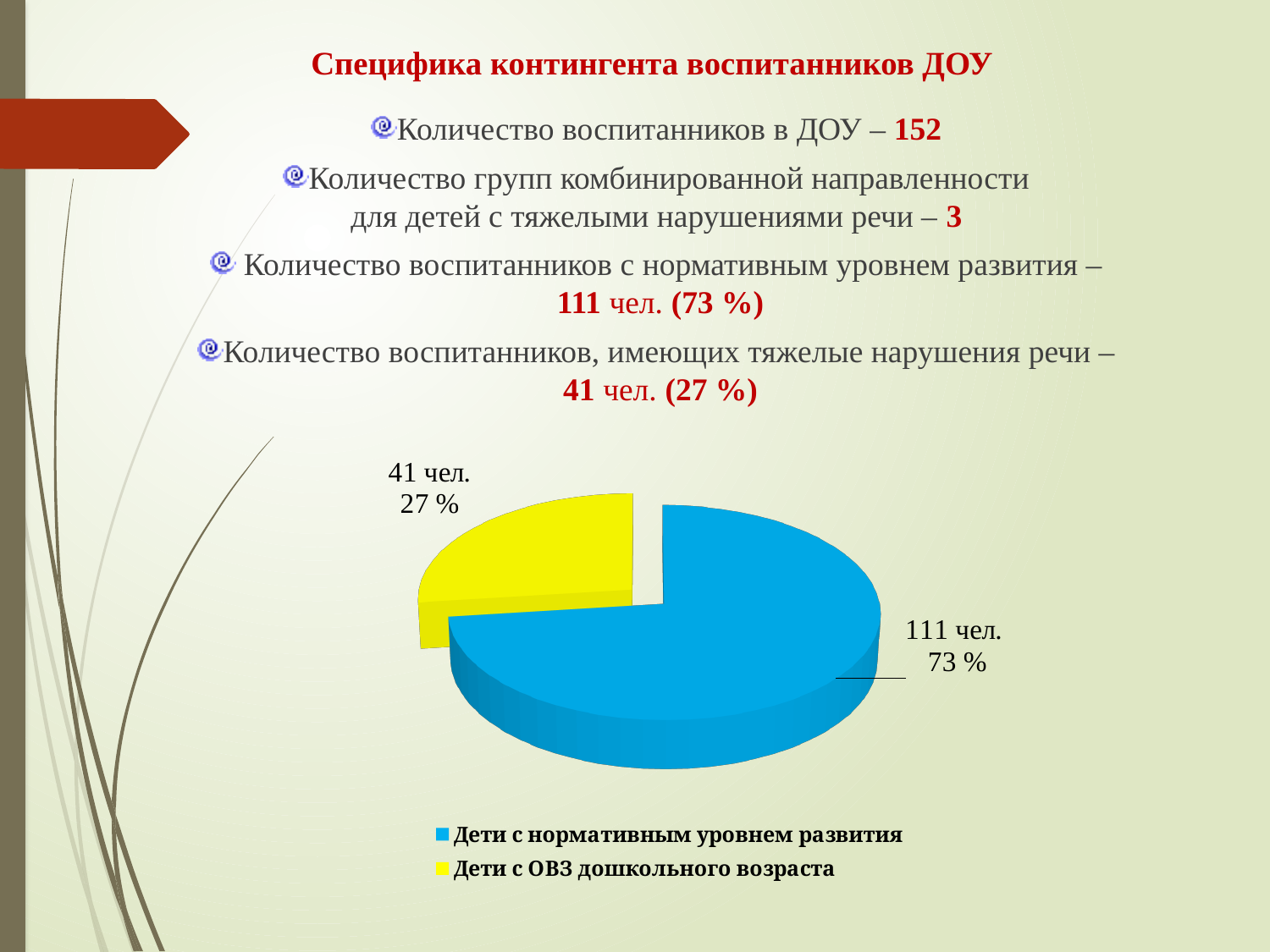
Which slice of the pie chart is the smallest? Дети с ОВЗ дошкольного возраста Which slice of the pie chart is the largest? Дети с нормативным уровнем развития What kind of chart is shown on the slide? pie chart How many slices does the pie chart have? 2 What share of the pie does the slice 'Дети с нормативным уровнем развития' represent? 73 % Which is larger: the slice 'Дети с нормативным уровнем развития' or the slice 'Дети с ОВЗ дошкольного возраста'? Дети с нормативным уровнем развития What share of the pie does the slice 'Дети с ОВЗ дошкольного возраста' represent? 27 % What value is shown for the slice 'Дети с нормативным уровнем развития'? 111 чел. What colour is the slice 'Дети с ОВЗ дошкольного возраста' in the pie chart? yellow How many entries does the legend of the pie chart list? 2 What is the difference in number of children between the 'Дети с нормативным уровнем развития' slice and the 'Дети с ОВЗ дошкольного возраста' slice? 70 чел. What value is shown for the slice 'Дети с ОВЗ дошкольного возраста'? 41 чел.